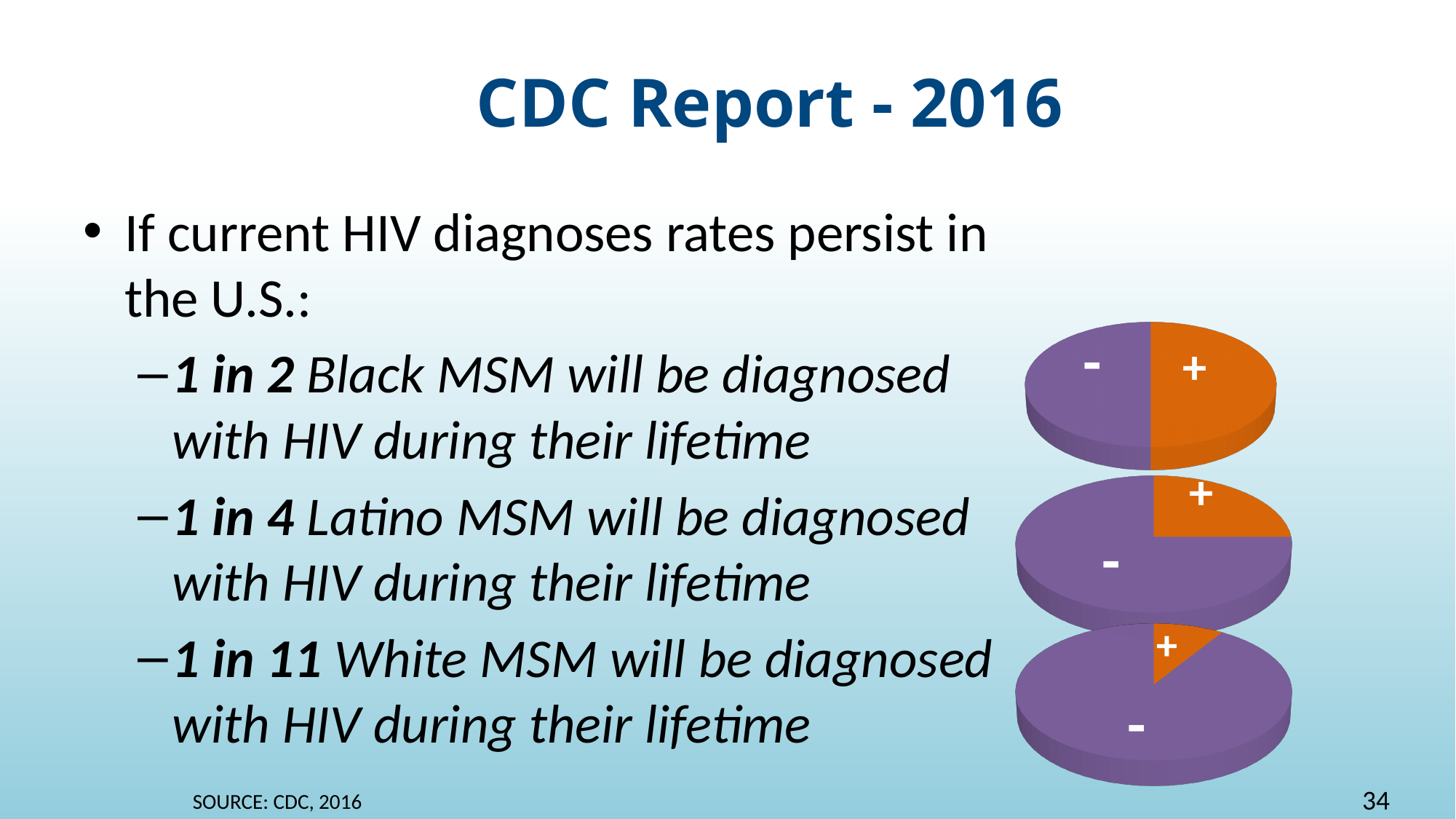
Which of the three pie charts has the largest "+" slice? The top pie chart In the middle pie chart, which slice is larger, "+" or "-"? - Is the "+" slice in the middle pie chart larger or smaller than the "+" slice in the top pie chart? Smaller How many slices does each pie chart have? 2 How many pie charts are on the slide? 3 What colour is the "-" slice in the pie charts? Purple In the bottom pie chart, which slice is larger, "+" or "-"? - Going from the top pie chart to the bottom pie chart, does the "+" slice get larger or smaller? Smaller Which of the three pie charts has the smallest "+" slice? The bottom pie chart What kind of charts are shown on the right side of the slide? Pie charts What colour is the "+" slice in the pie charts? Orange